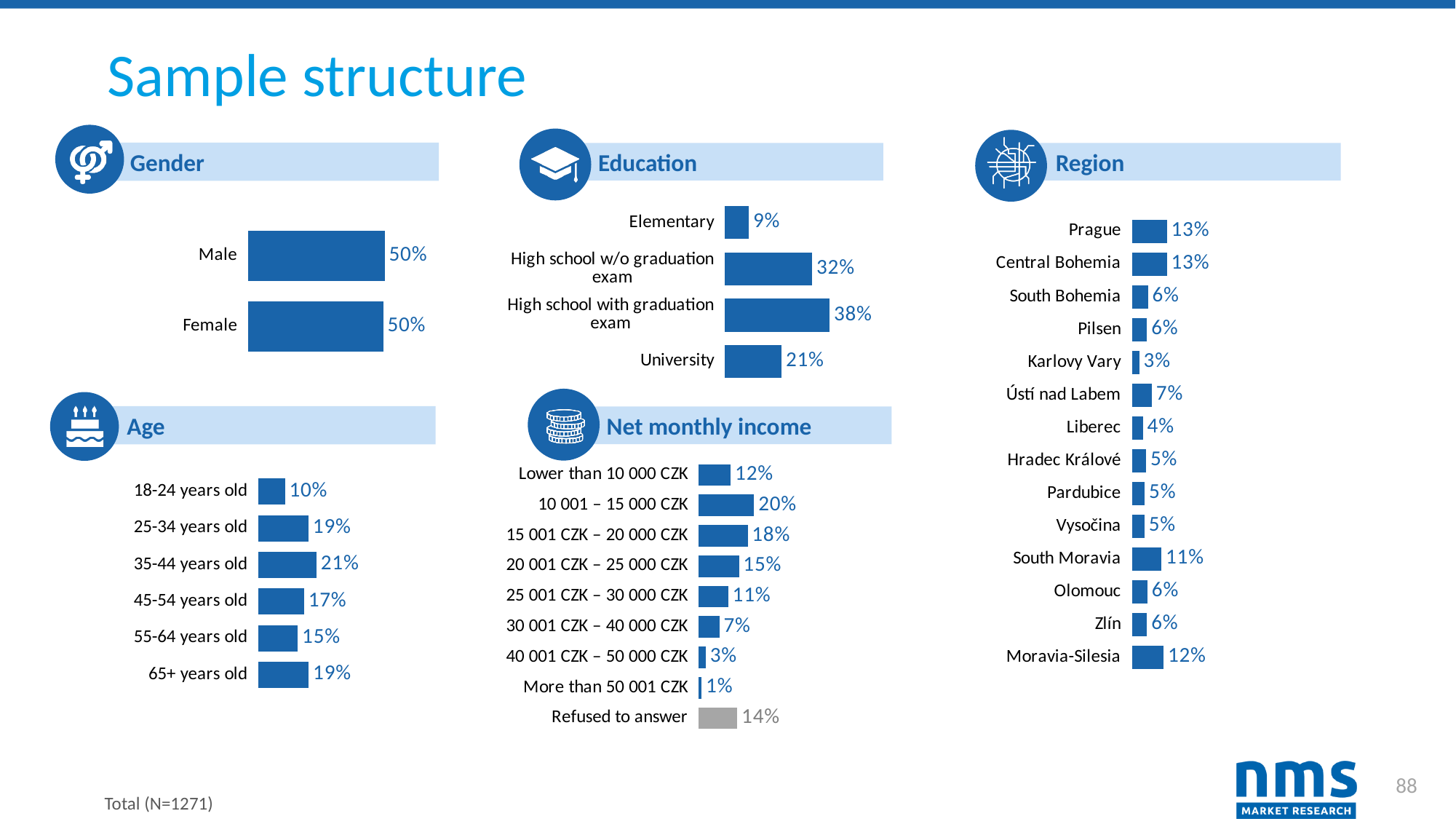
In the Net monthly income chart, what is the difference between the values for 10 001 – 15 000 CZK and 40 001 – 50 000 CZK? 17% In the Net monthly income chart, what is the value for Refused to answer? 14% In the Region chart, what is the value for South Moravia? 11% In the Education chart, what is the value for University? 21% What kind of chart is the Gender chart? Bar chart In the Net monthly income chart, which bar is shown in grey rather than blue? Refused to answer In the Age chart, which age group has the lowest value? 18-24 years old In the Region chart, which region has the lowest value? Karlovy Vary How many categories does the Net monthly income chart show? 9 In the Region chart, which is larger, the value for Prague or the value for Moravia-Silesia? Prague In the Education chart, which category has the highest value? High school with graduation exam How many categories does the Region chart show? 14